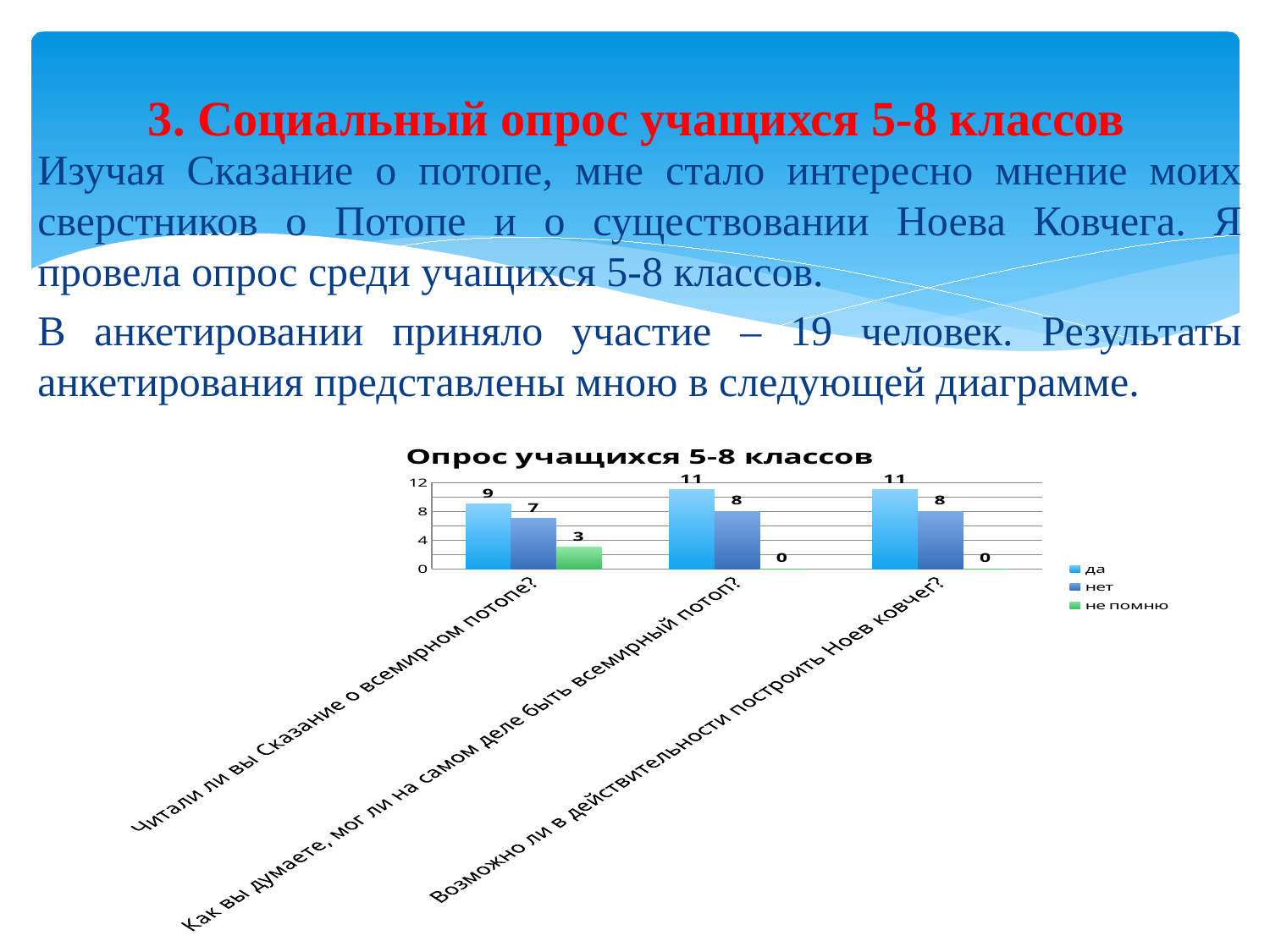
What is the value of the "да" series for "Читали ли вы Сказание о всемирном потопе?"? 9 Which series is shown in green in the chart legend? не помню What is the value of the "не помню" series for "Читали ли вы Сказание о всемирном потопе?"? 3 What is the difference between the "да" and "нет" values for "Возможно ли в действительности построить Ноев ковчег?"? 3 How many question categories are shown on the x axis of the chart? 3 Which is larger for "Читали ли вы Сказание о всемирном потопе?": the "да" value or the "нет" value? да What type of chart is shown on the slide? bar chart What is the value of the "нет" series for "Как вы думаете, мог ли на самом деле быть всемирный потоп?"? 8 What is the title of the chart? Опрос учащихся 5-8 классов Which series has the lowest value for "Читали ли вы Сказание о всемирном потопе?"? не помню What is the value of the "не помню" series for "Возможно ли в действительности построить Ноев ковчег?"? 0 How many series does the chart legend list? 3